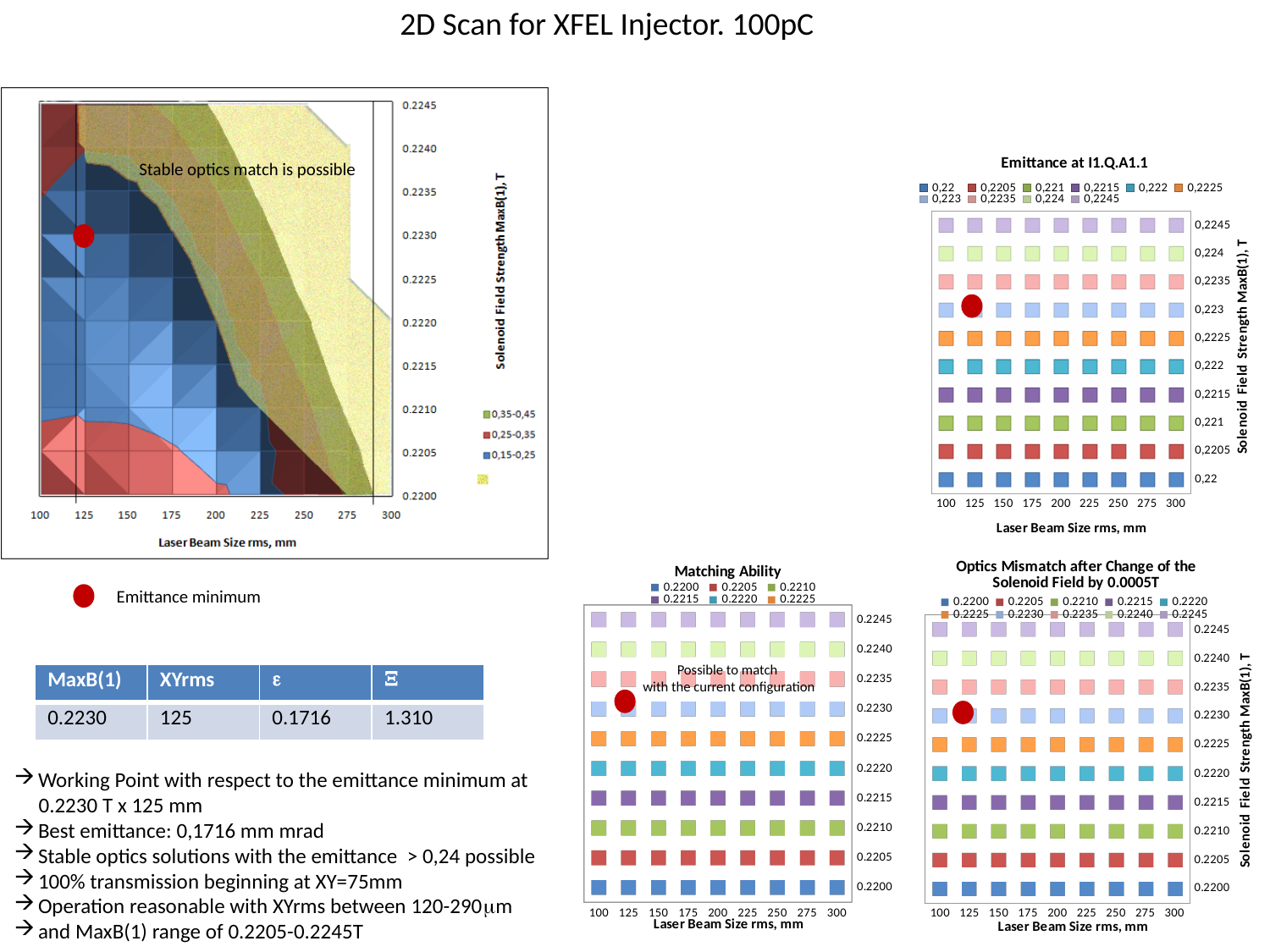
How many series does the legend of the 'Optics Mismatch after Change of the Solenoid Field by 0.0005T' chart list? 10 In the 'Emittance at I1.Q.A1.1' chart, at which laser beam size (mm) is the red emittance-minimum marker placed? 125 What is the highest solenoid field strength tick on the y axis of the large contour chart on the left of the slide? 0.2245 What is the lowest solenoid field strength tick shown on the y axis of the 'Optics Mismatch after Change of the Solenoid Field by 0.0005T' chart? 0.2200 What is the x-axis title of the 'Emittance at I1.Q.A1.1' chart? Laser Beam Size rms, mm How many series does the legend of the 'Emittance at I1.Q.A1.1' chart list? 10 In the 'Optics Mismatch after Change of the Solenoid Field by 0.0005T' chart, at which solenoid field strength is the red marker placed? 0.2230 In the 'Matching Ability' chart, how many solenoid field strength ticks are labelled on the y axis? 10 In the 'Matching Ability' chart, how many laser beam size values are marked along the x axis? 9 How many series does the legend of the 'Matching Ability' chart list? 6 What is the largest laser beam size value shown on the x axis of the 'Matching Ability' chart? 300